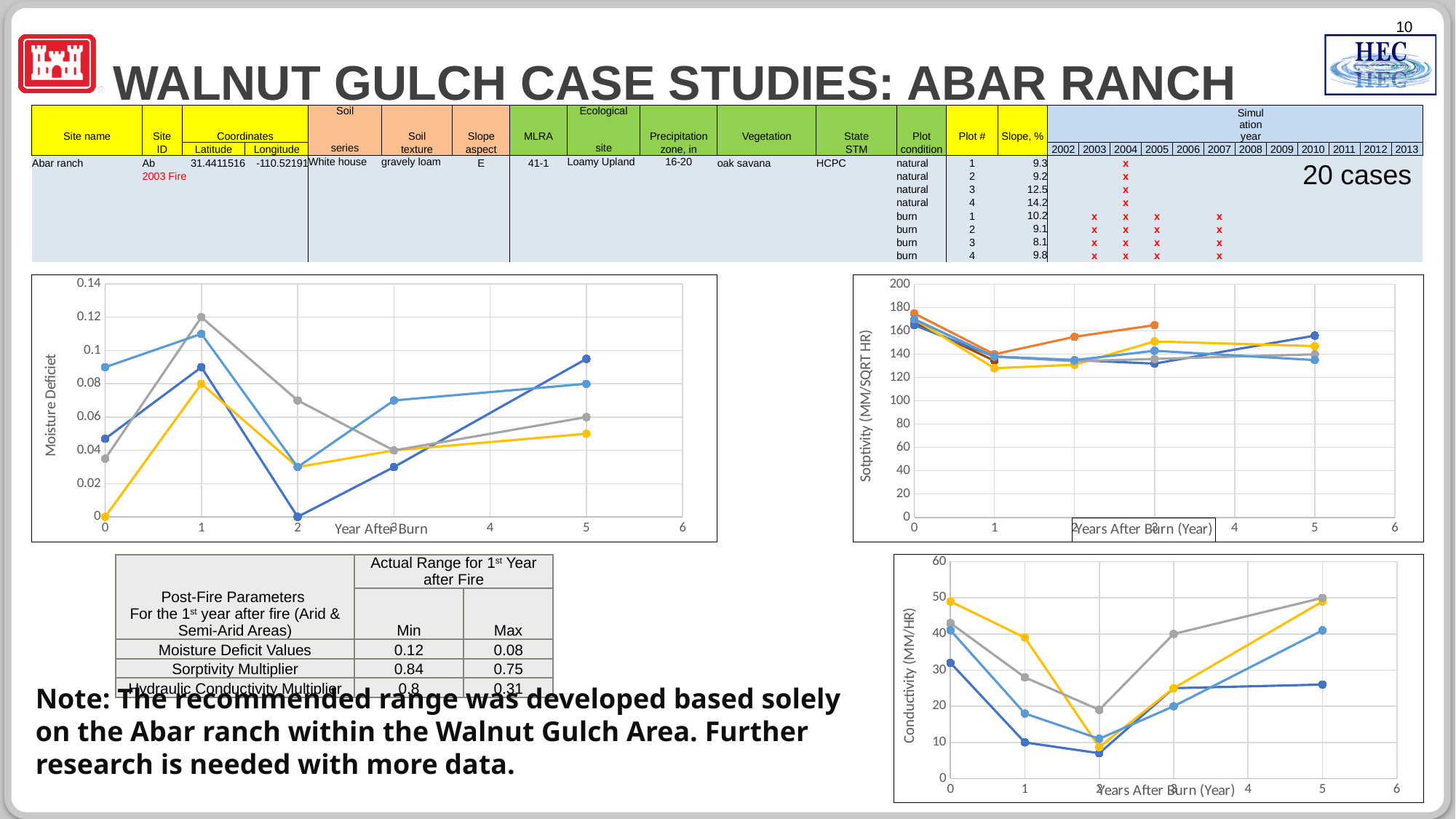
On the Sorptivity chart, is the orange series value at year 0 greater or less than 160? greater How many lines (series) are plotted on the Conductivity chart at the bottom right? 4 On the Conductivity chart, at which year does the dark blue series reach its lowest value? 2 What is the y-axis title of the Conductivity chart at the bottom right? Conductivity (MM/HR) On the Moisture Deficit chart, is the grey series value at year 1 greater or less than 0.1? greater On the Moisture Deficit chart, is the dark blue series value at year 2 greater or less than 0.02? less On the Conductivity chart, do the values rise or fall between year 2 and year 5? rise How many lines (series) are plotted on the Sorptivity chart at the top right? 6 On the Moisture Deficit chart, how many data points does each line have? 5 On the Sorptivity chart, which series has the highest value at year 0? the orange series What kind of chart is the Moisture Deficit chart on the left of the slide? line chart